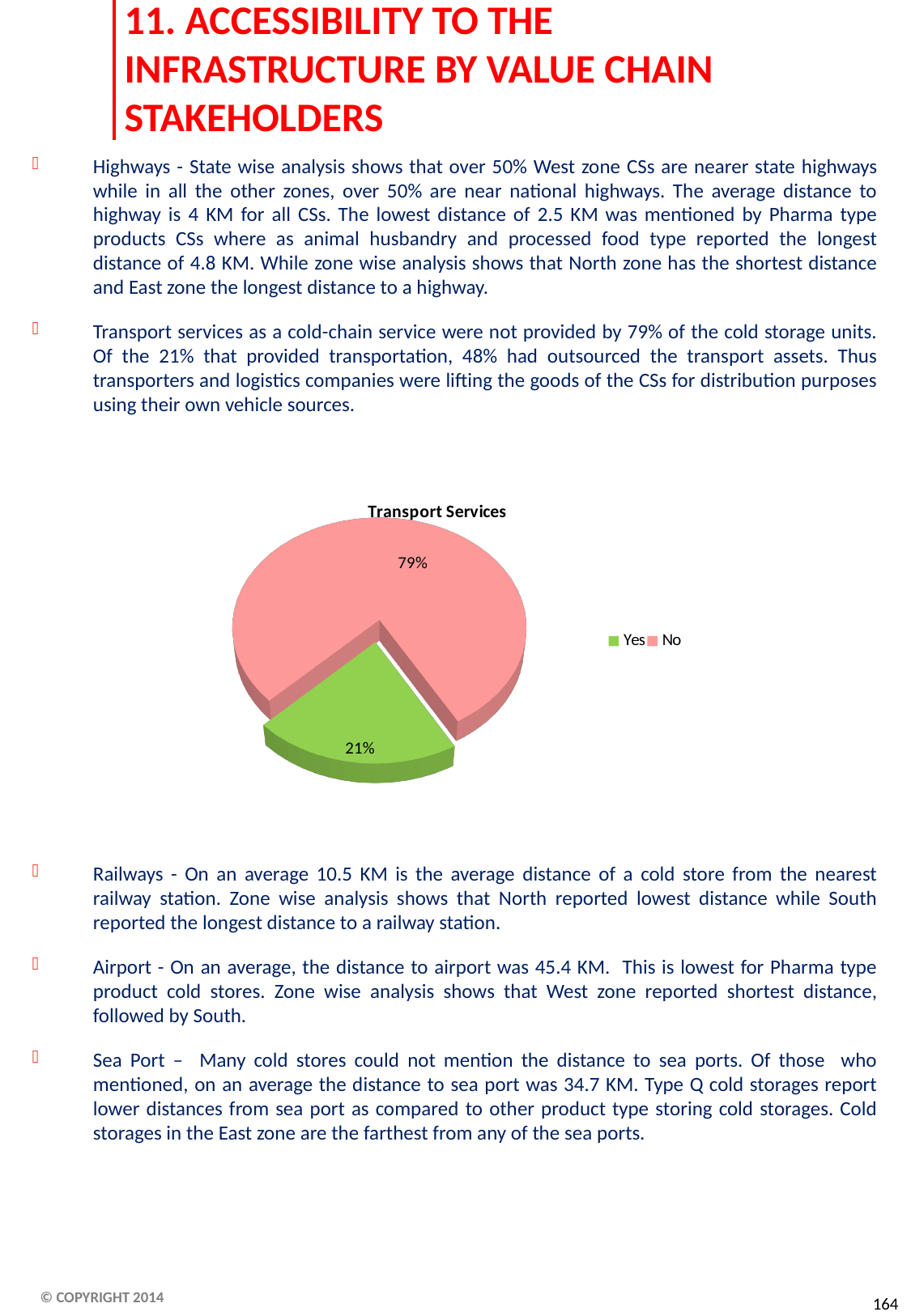
Which slice of the pie is the smallest? Yes What kind of chart is shown on the slide? Pie chart What share of the pie is labelled 'No'? 79% What is the difference in percentage points between the 'No' and 'Yes' slices? 58 Which is larger, the 'Yes' slice or the 'No' slice? No What is the total of the two slice percentages shown? 100% What colour is the 'Yes' slice? Green What share of the pie is labelled 'Yes'? 21% How many slices does the pie chart have? 2 What is the title of the chart? Transport Services How many entries does the legend list? 2 Which slice of the pie is the largest? No